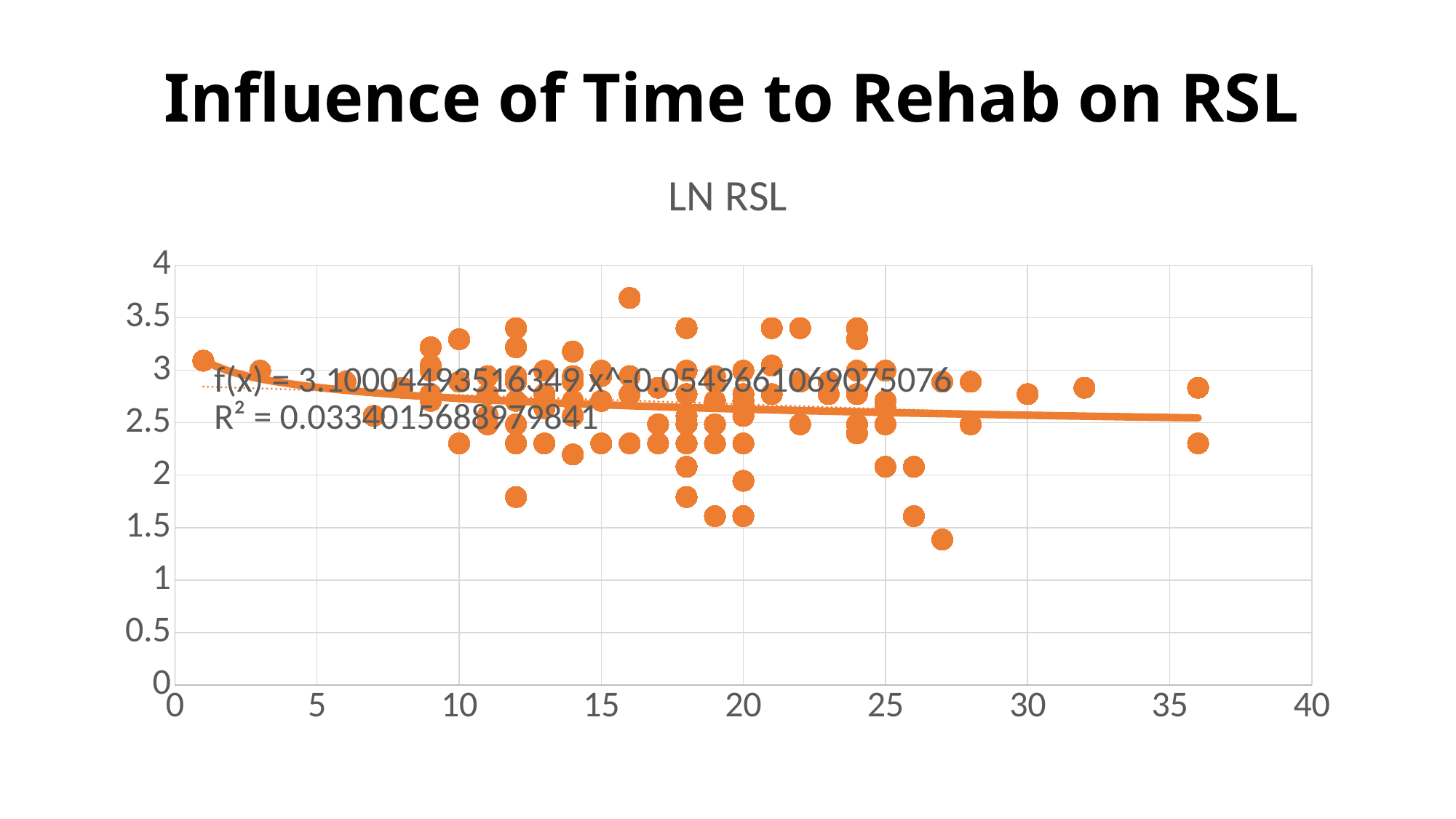
What is the title of the chart? LN RSL What R² value is printed on the chart? R² = 0.0334015688979841 Is the lowest plotted point greater or less than 1.5? less Is the trendline value at x = 1 greater or less than 2.5? greater What is the maximum value shown on the x axis? 40 What kind of chart is shown on the slide? scatter plot Does the fitted trendline rise or fall as the x value increases? fall Is the highest plotted point greater or less than 3.5? greater